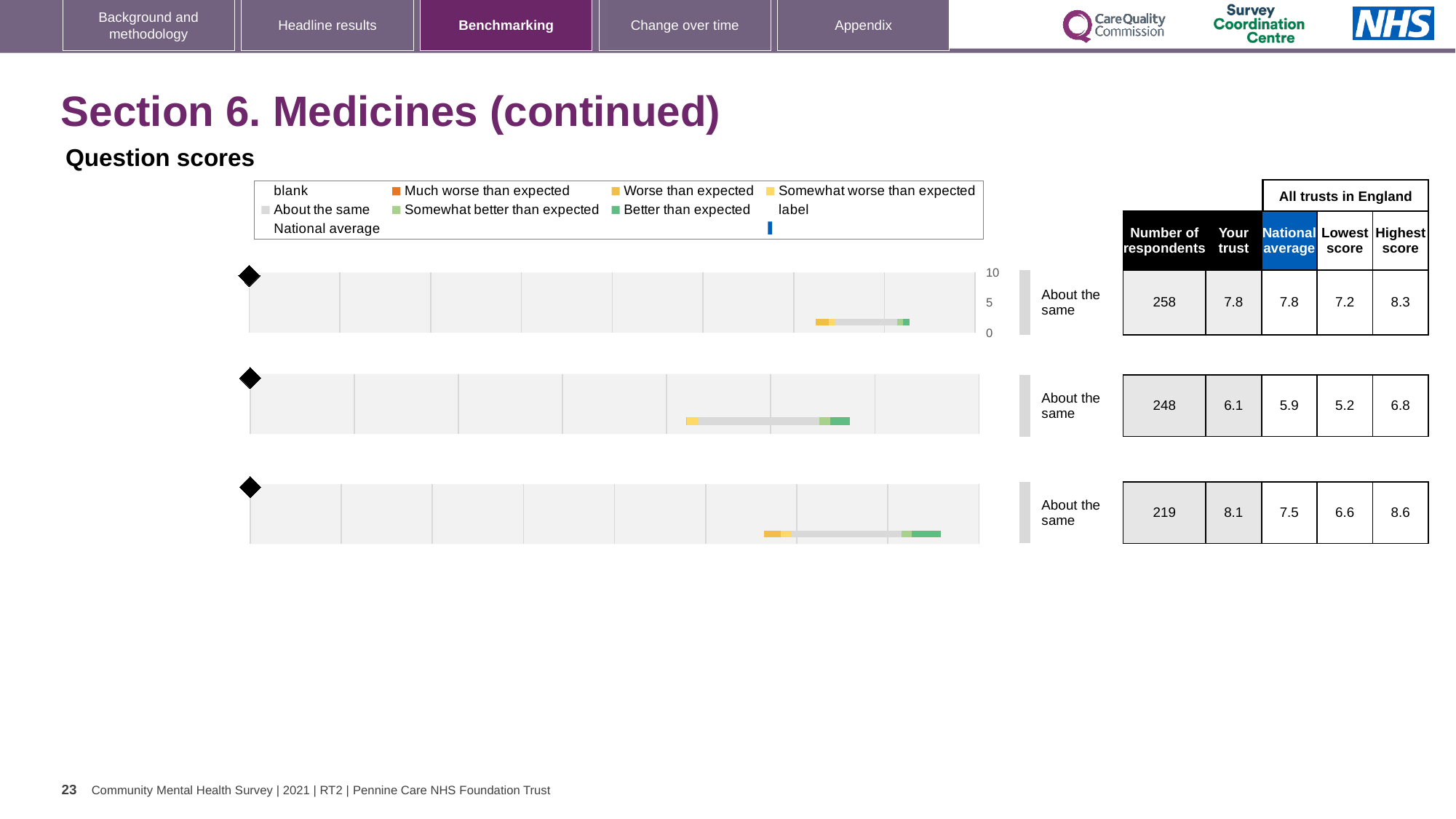
What benchmark category is shown next to each of the three charts? About the same For the middle chart, what is the difference between the highest score and the lowest score? 1.6 Which of the three charts has the highest 'Your trust' score? the bottom chart For the bottom chart, which is larger: the 'Your trust' score or the national average? Your trust For the middle chart, what is the national average score? 5.9 What is the maximum value shown on the axis of the top chart? 10 For the top chart, what is the 'Your trust' score? 7.8 How many charts are shown on the slide? 3 What kind of chart is the top chart on the slide? bar chart For the bottom chart, what is the highest score among all trusts in England? 8.6 For the top chart, what is the number of respondents? 258 For the top chart, is the 'Your trust' score greater or less than 5? greater